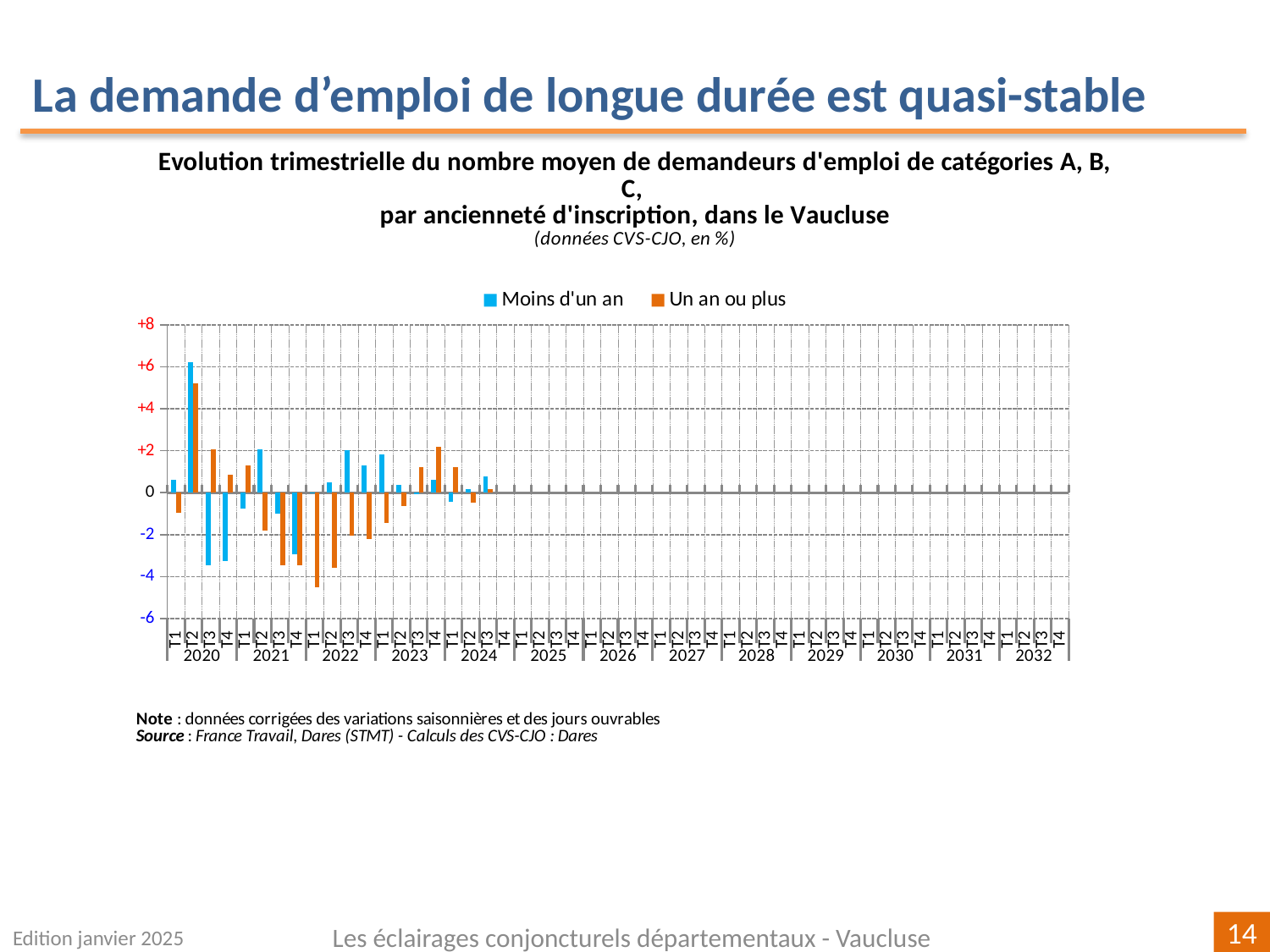
Which colour represents the series 'Un an ou plus'? orange In T2 2020, which series has the larger value, 'Moins d'un an' or 'Un an ou plus'? Moins d'un an Is the value for 'Moins d'un an' in T2 2020 greater or less than +4? greater How many years are labelled along the x axis? 13 In which quarter does the series 'Un an ou plus' reach its lowest value? T1 2022 Is the value for 'Un an ou plus' in T2 2020 greater or less than +4? greater What kind of chart is shown on the slide? bar chart How many series does the legend list? 2 Is the value for 'Moins d'un an' in T3 2020 greater or less than -2? less What are the two series named in the legend? Moins d'un an; Un an ou plus In which quarter does the series 'Moins d'un an' reach its highest value? T2 2020